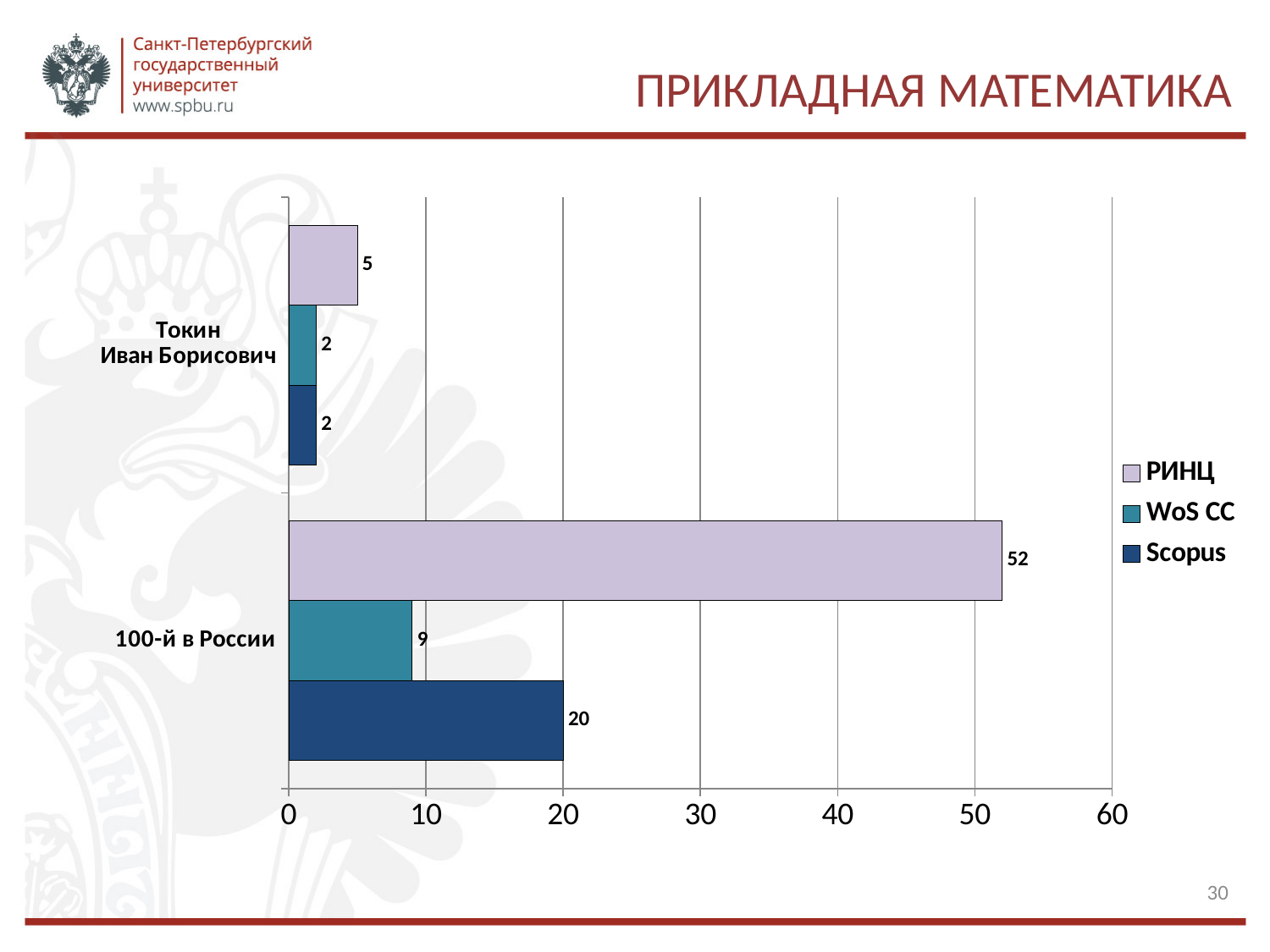
Which series has the lowest value for 100-й в России? WoS CC What is the Scopus value for 100-й в России? 20 What is the difference between the РИНЦ values for 100-й в России and Токин Иван Борисович? 47 What is the WoS CC value for 100-й в России? 9 Which is larger: the Scopus value for 100-й в России or the Scopus value for Токин Иван Борисович? 100-й в России Is the РИНЦ value for 100-й в России greater or less than 50? greater Which series has the highest value for 100-й в России? РИНЦ What is the РИНЦ value for Токин Иван Борисович? 5 How many categories are shown on the vertical axis? 2 How many series does the legend list? 3 What kind of chart is shown on the slide? bar chart What is the WoS CC value for Токин Иван Борисович? 2